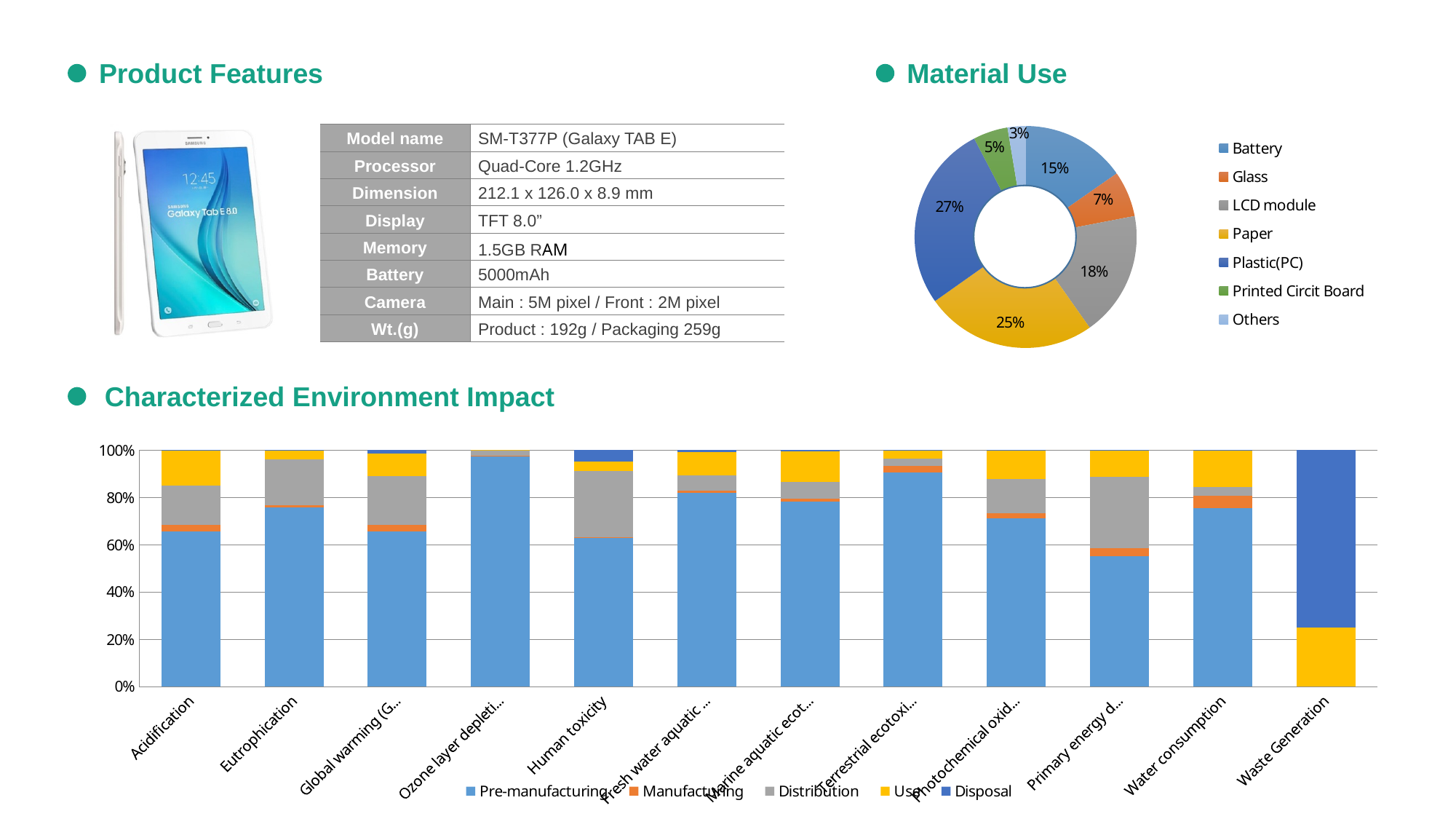
In the Material Use chart, which material has the largest share? Plastic(PC) What kind of chart is the Characterized Environment Impact chart? Stacked bar chart In the Characterized Environment Impact chart, how many impact categories are shown on the x axis? 12 In the Characterized Environment Impact chart, how many series does the legend list? 5 In the Material Use chart, what share does Paper account for? 25% In the Material Use chart, which material has the smallest share? Others In the Characterized Environment Impact chart, which category has no Pre-manufacturing segment and is dominated by Disposal? Waste Generation In the Material Use chart, how many percentage points larger is the LCD module share than the Glass share? 11% In the Material Use chart, which is larger, the Battery share or the LCD module share? LCD module In the Material Use chart, what share does Plastic(PC) account for? 27% In the Characterized Environment Impact chart, is the Pre-manufacturing value for Ozone layer depletion greater or less than 80%? greater In the Material Use chart, how many materials are shown in the legend? 7